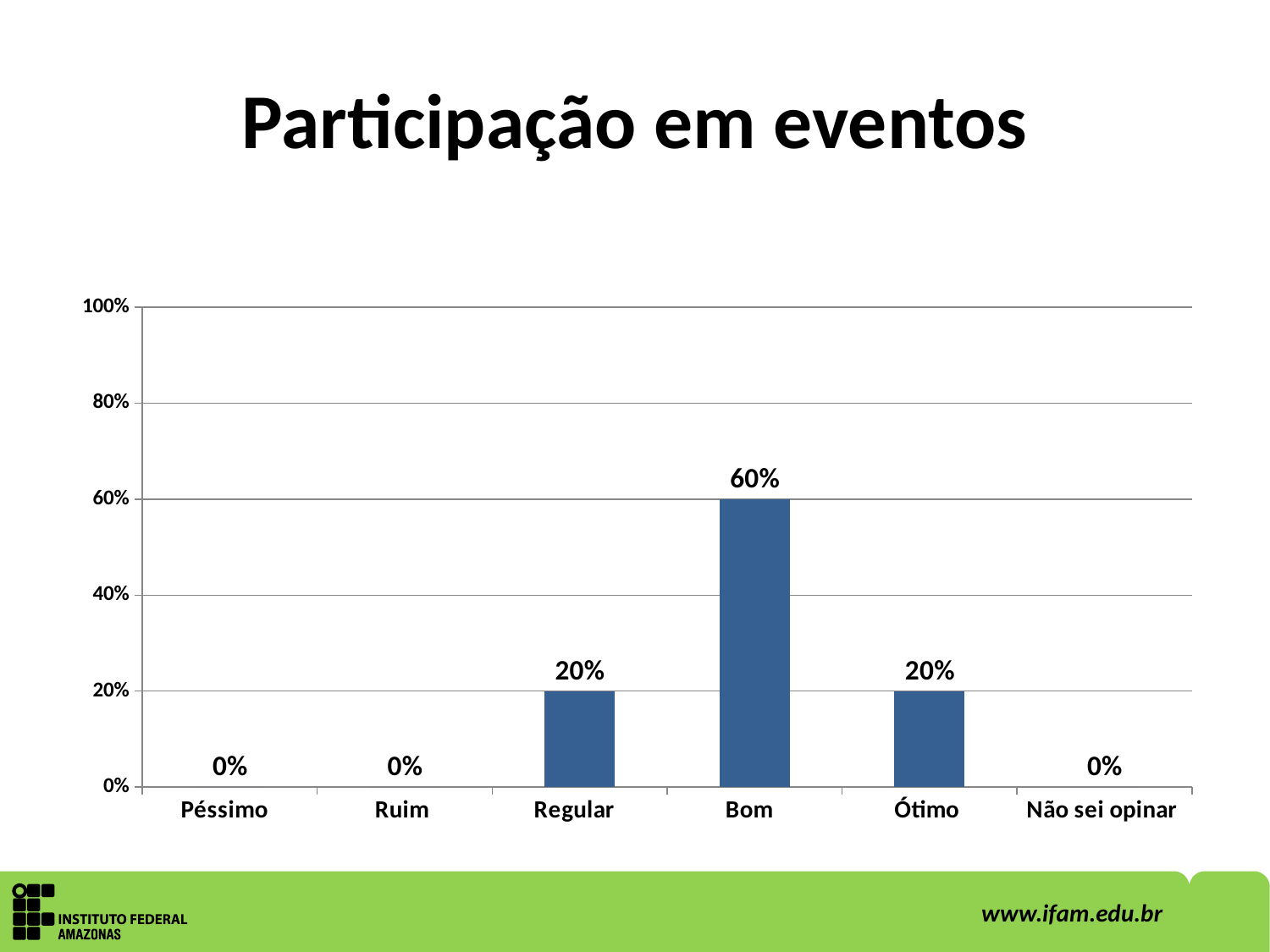
Is the value for Bom greater or less than 40%? greater What is the value for Péssimo? 0% What is the value for Regular? 20% What is the title of the slide? Participação em eventos What is the value for Não sei opinar? 0% What kind of chart is shown on the slide? bar chart How many categories are shown on the x axis? 6 Which category has the highest value? Bom What is the value for Bom? 60% How many categories have a value of 0%? 3 What is the difference between the values for Bom and Ótimo? 40% Which is larger, the value for Bom or the value for Regular? Bom